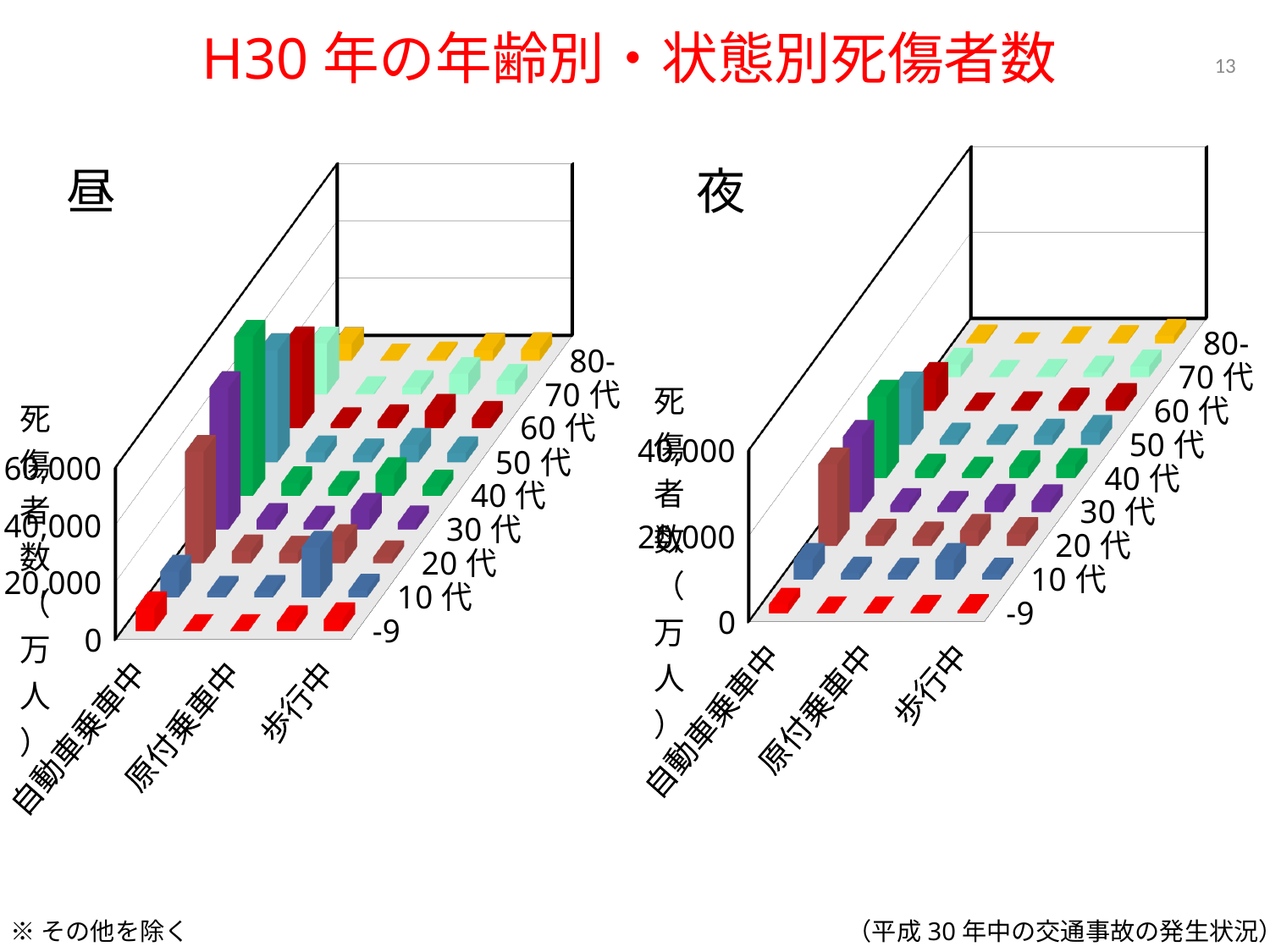
In the 昼 chart, is the value for 自動車乗車中 in the -9 age group greater or less than 20,000? less In the 昼 chart, is the value for 自動車乗車中 in the 20代 age group greater or less than 20,000? greater What is the highest value shown on the vertical axis of the 夜 chart? 40,000 What kind of chart is the 昼 chart on the left? bar chart In the 昼 chart, is the value for 歩行中 in the 80- age group greater or less than 20,000? less In the 夜 chart, which state category has the tallest bars? 自動車乗車中 What is the highest value shown on the vertical axis of the 昼 chart? 60,000 How many age groups are shown along the depth axis of the 昼 chart? 9 In the 昼 chart, which is larger for the 20代 age group: 自動車乗車中 or 歩行中? 自動車乗車中 In the 夜 chart, which is larger for the 20代 age group: 自動車乗車中 or 歩行中? 自動車乗車中